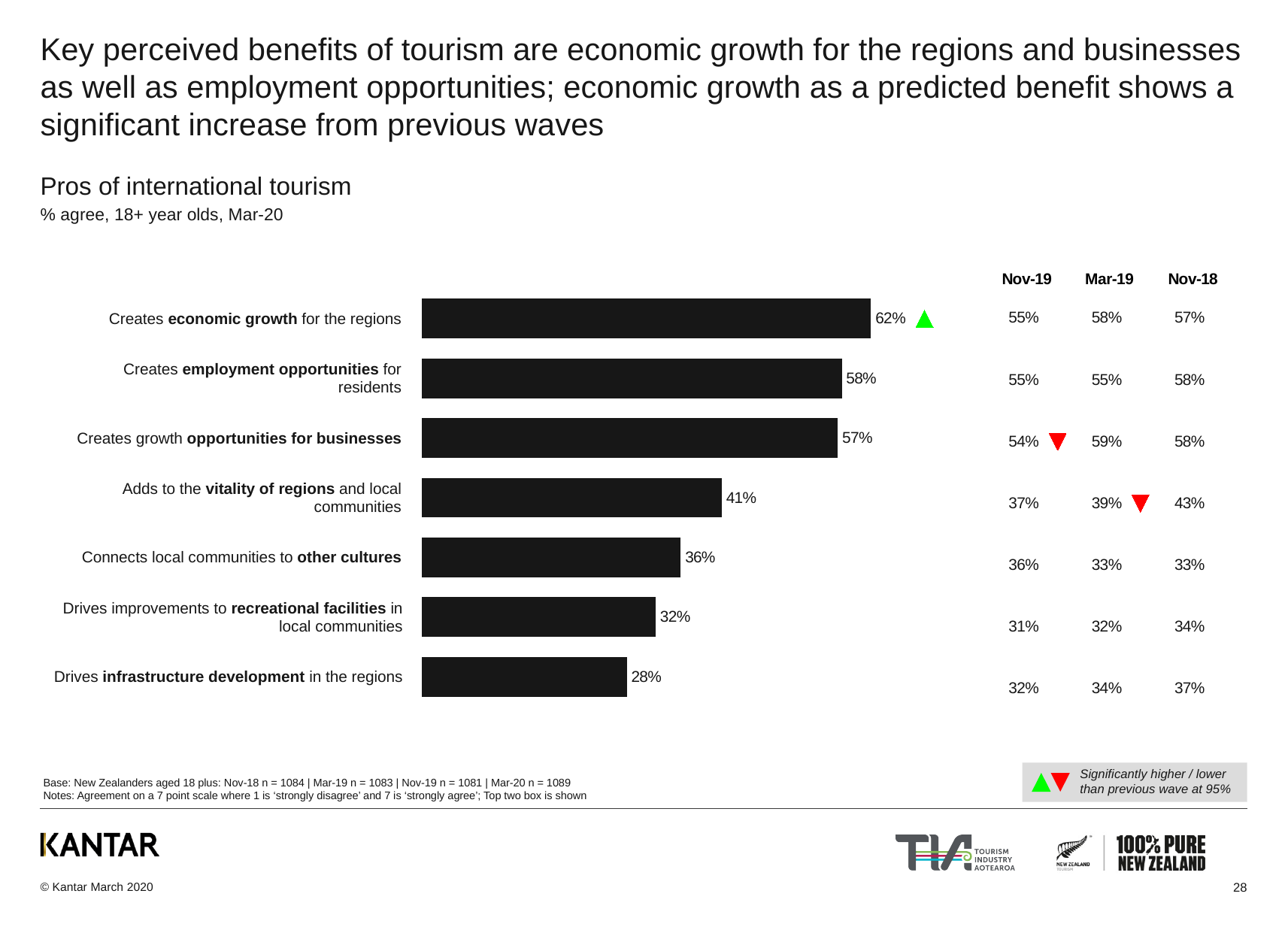
Which pro of international tourism has the highest level of agreement in Mar-20? Creates economic growth for the regions How many pros of international tourism are shown as bars in the chart? 7 What is the difference in Mar-20 agreement between 'Creates economic growth for the regions' and 'Drives infrastructure development in the regions'? 34 percentage points What percentage agree that international tourism creates economic growth for the regions (Mar-20)? 62% What is the title of the chart? Pros of international tourism What was the Nov-18 agreement for 'Adds to the vitality of regions and local communities'? 43% What was the Nov-19 agreement for 'Creates growth opportunities for businesses'? 54% Which pro of international tourism has the lowest level of agreement in Mar-20? Drives infrastructure development in the regions What percentage agree that international tourism drives infrastructure development in the regions (Mar-20)? 28% What percentage agree that international tourism connects local communities to other cultures (Mar-20)? 36% What kind of chart is used to show the pros of international tourism? Bar chart Which has higher Mar-20 agreement: 'Adds to the vitality of regions and local communities' or 'Drives improvements to recreational facilities in local communities'? Adds to the vitality of regions and local communities